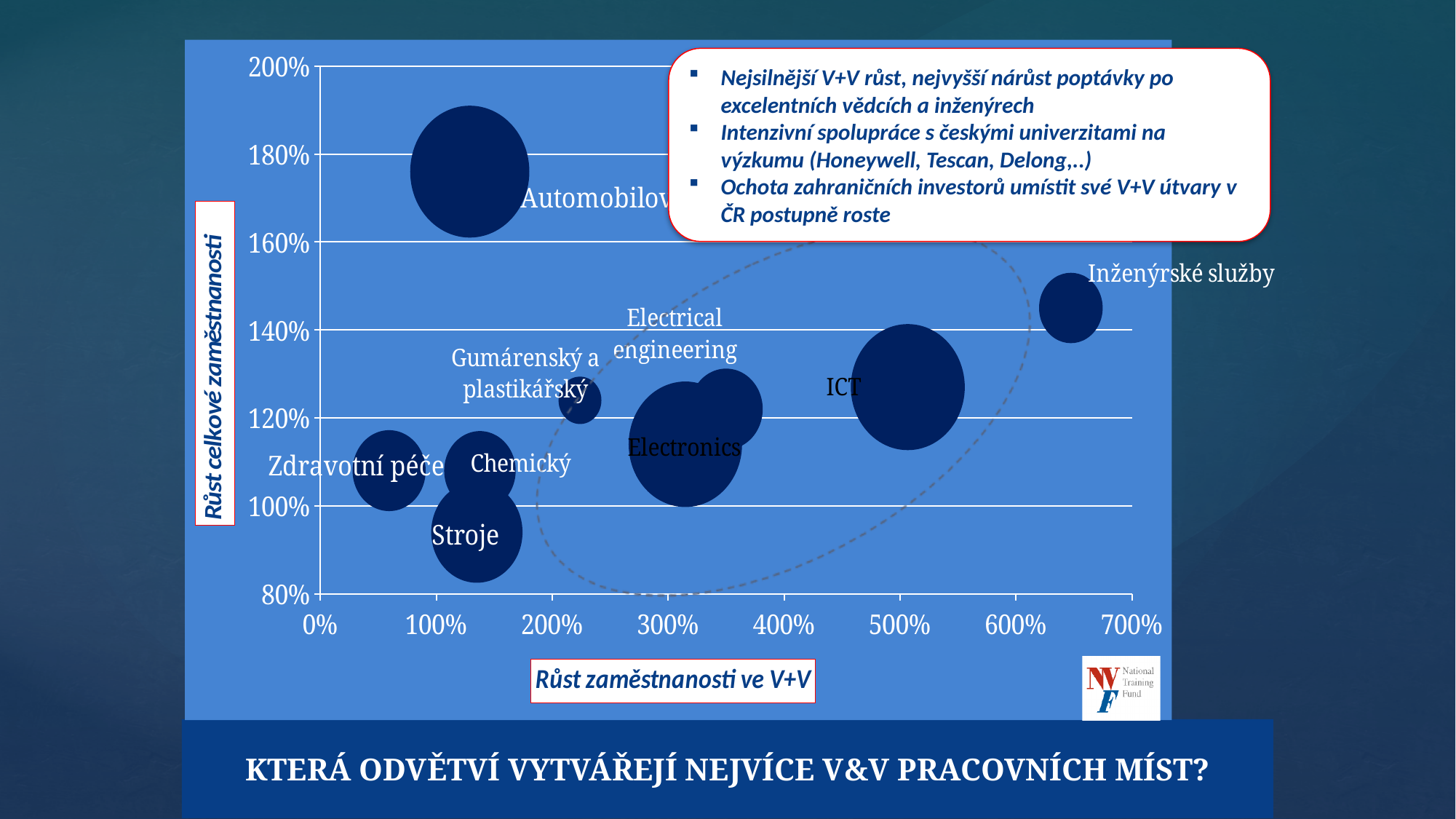
Which has the larger horizontal-axis value (Růst zaměstnanosti ve V+V), ICT or Stroje? ICT Is the horizontal-axis value for Inženýrské služby greater or less than 600%? greater Is the vertical-axis value for Stroje greater or less than 100%? less What kind of chart is shown on the slide? bubble chart Which sector has the lowest value on the vertical axis (Růst celkové zaměstnanosti)? Stroje What is the title of the horizontal axis? Růst zaměstnanosti ve V+V Which sector is furthest to the left on the horizontal axis (Růst zaměstnanosti ve V+V)? Zdravotní péče Which sector is furthest to the right on the horizontal axis (Růst zaměstnanosti ve V+V)? Inženýrské služby Which sector has the highest value on the vertical axis (Růst celkové zaměstnanosti)? Automobilový How many labelled bubbles (sectors) are plotted on the chart? 9 Is the horizontal-axis value for ICT greater or less than 400%? greater